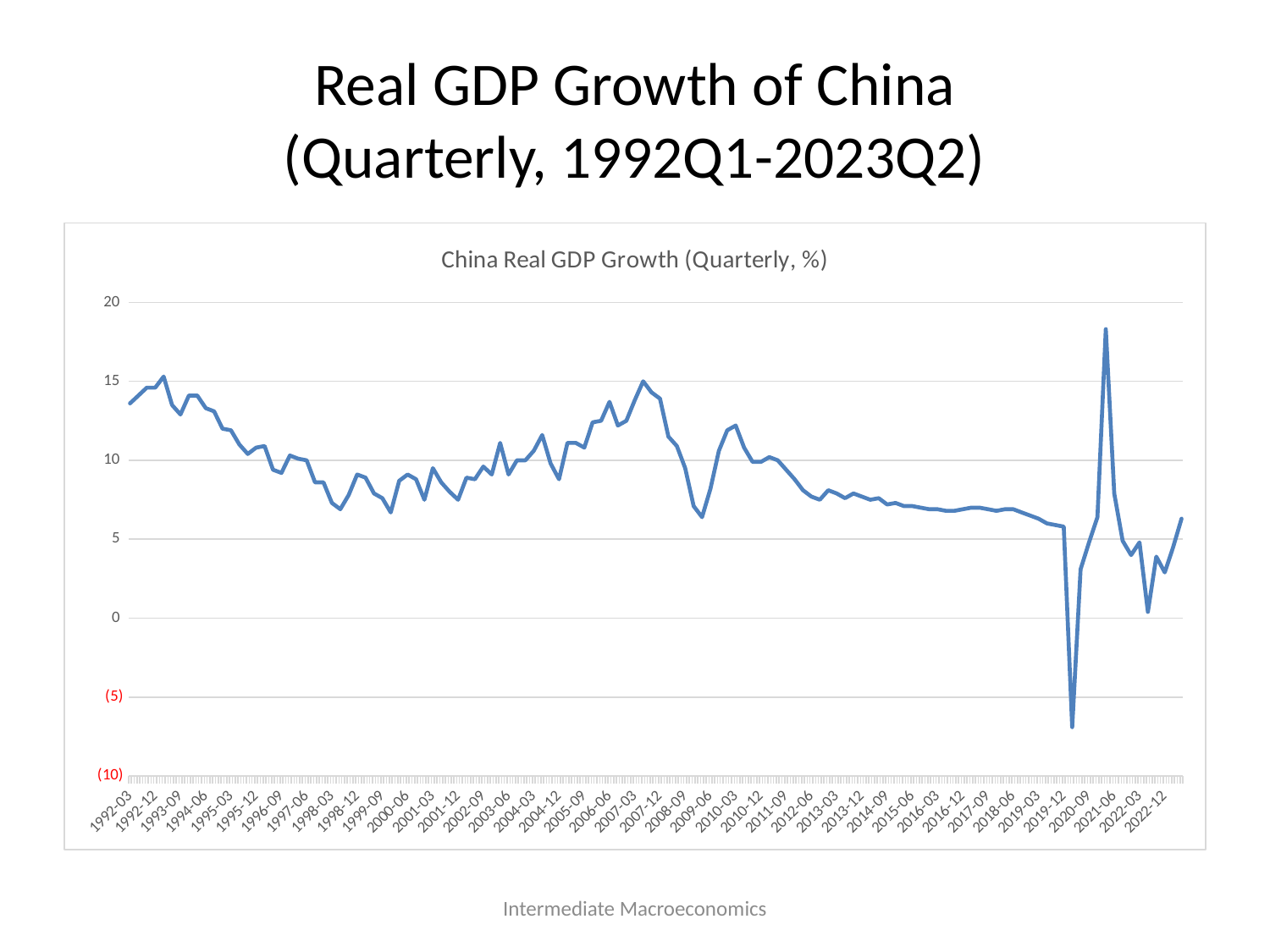
What colour is the line plotted in the chart? blue Is the value for 2007-03 greater or less than 10? greater What kind of chart is shown on the slide? line chart Is the value for 1992-03 greater or less than 10? greater Between 2010-03 and 2019-12, do the values generally rise or fall? fall Is the value for 2016-03 greater or less than 10? less In which year does the line reach its highest value? 2021 In which year does the line reach its lowest value? 2020 What is the title printed inside the chart area? China Real GDP Growth (Quarterly, %)